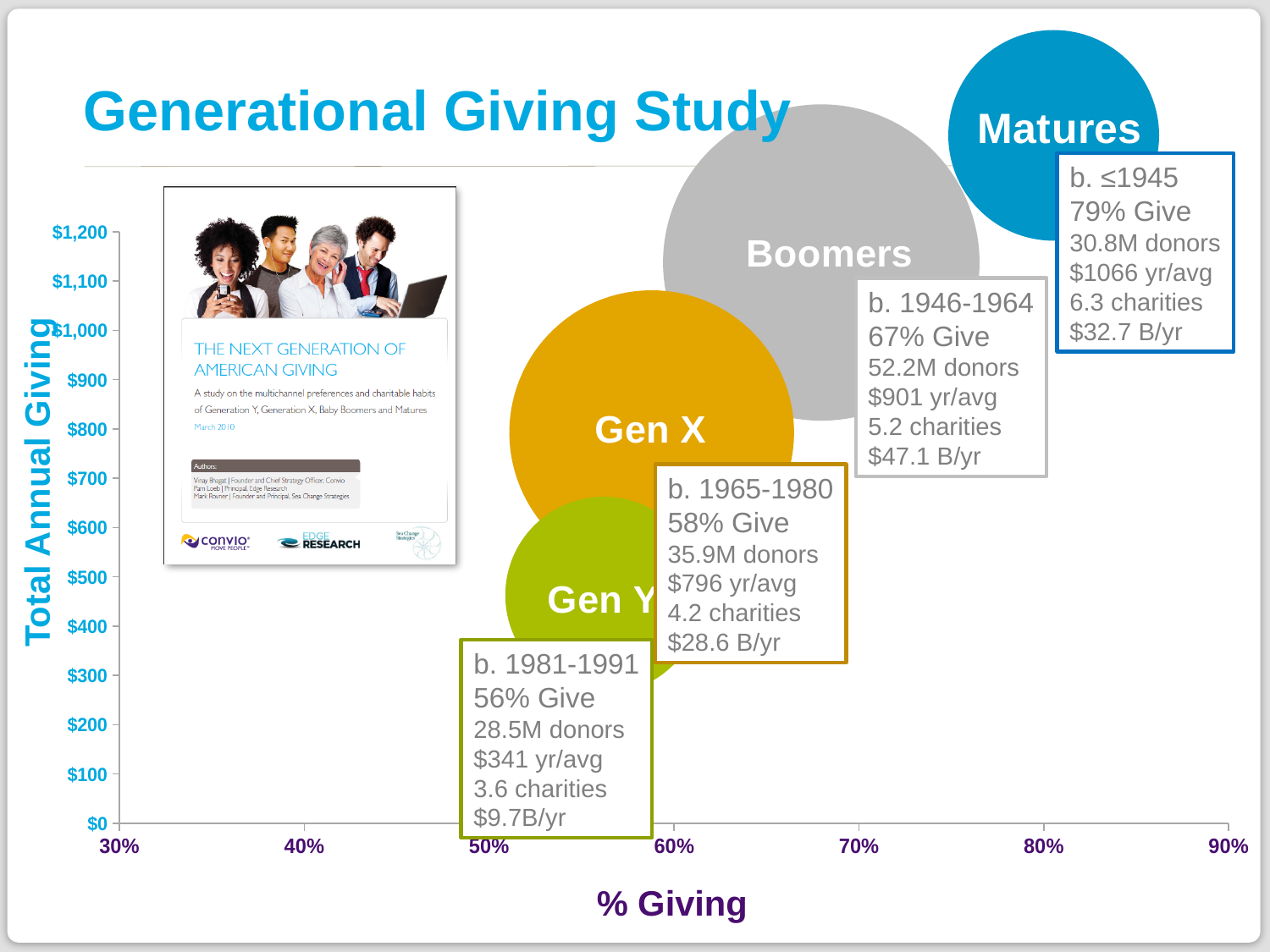
What is the difference in percentage giving between Matures and Gen Y? 23% How many generations are plotted on the chart? 4 How many donors are there in the Boomers generation? 52.2M donors Which generation has the highest percentage giving? Matures What is the label of the x axis of the chart? % Giving What percentage of Matures give, according to the chart? 79% Which generation has more donors, Gen X or Matures? Gen X Which generation gives the most in total billions per year? Boomers What is the average annual giving per donor for Gen X? $796 yr/avg What is the total annual giving in billions per year for Gen Y? $9.7B/yr Which generation has the lowest average annual giving per donor? Gen Y What kind of chart is shown on the slide? Bubble chart